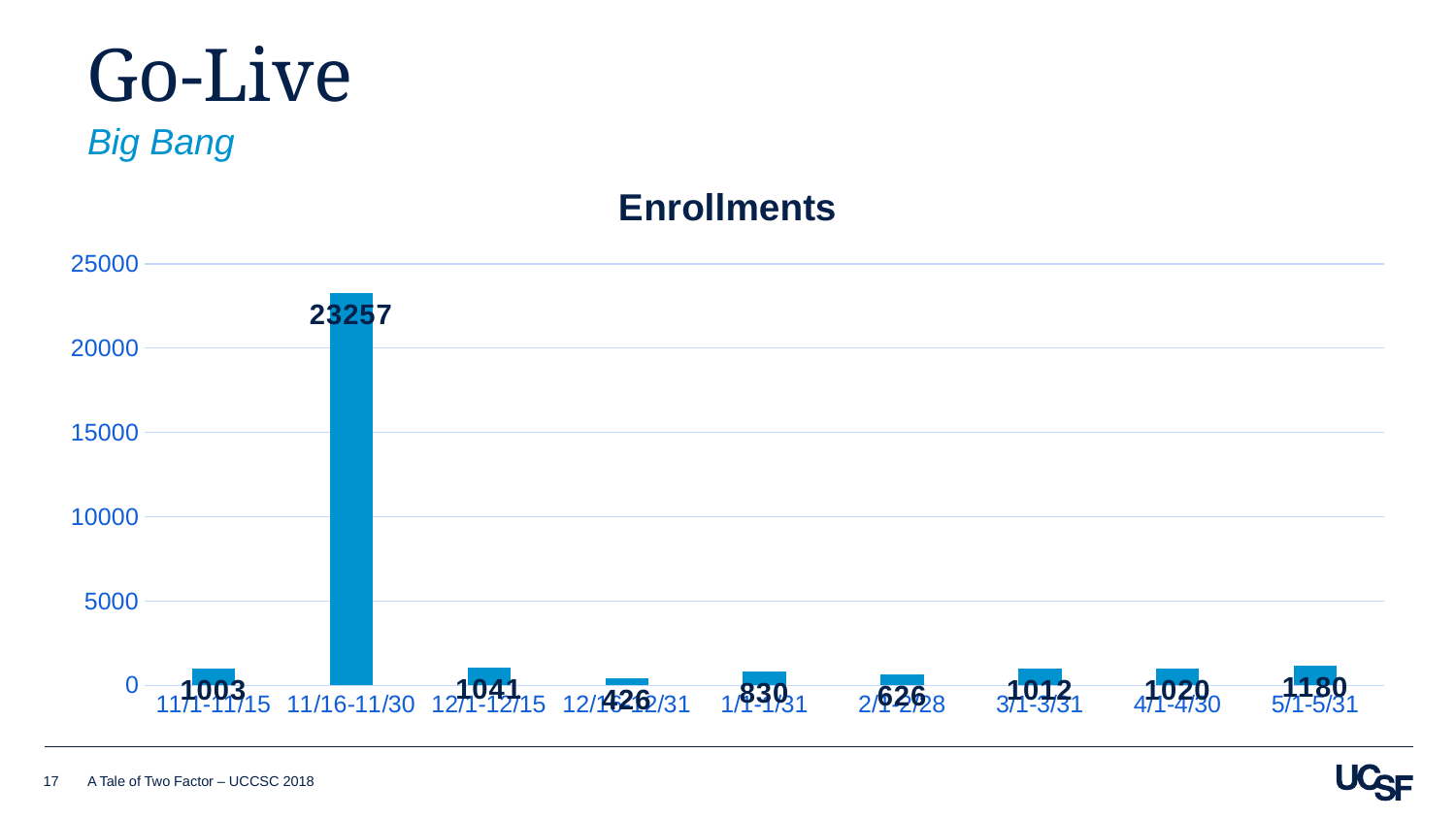
What type of chart is shown on the slide? bar chart Which period has more enrollments, 2/1-2/28 or 3/1-3/31? 3/1-3/31 What is the enrollment value for 11/16-11/30? 23257 What is the difference in enrollments between 11/16-11/30 and 11/1-11/15? 22254 What is the enrollment value for 5/1-5/31? 1180 What is the enrollment value for 1/1-1/31? 830 How many categories (time periods) are plotted in the Enrollments chart? 9 What is the title of the chart? Enrollments What is the difference in enrollments between 5/1-5/31 and 4/1-4/30? 160 Is the value for 11/16-11/30 greater or less than 20000? greater Which period has the highest enrollments? 11/16-11/30 Which period has the lowest enrollments? 12/16-12/31